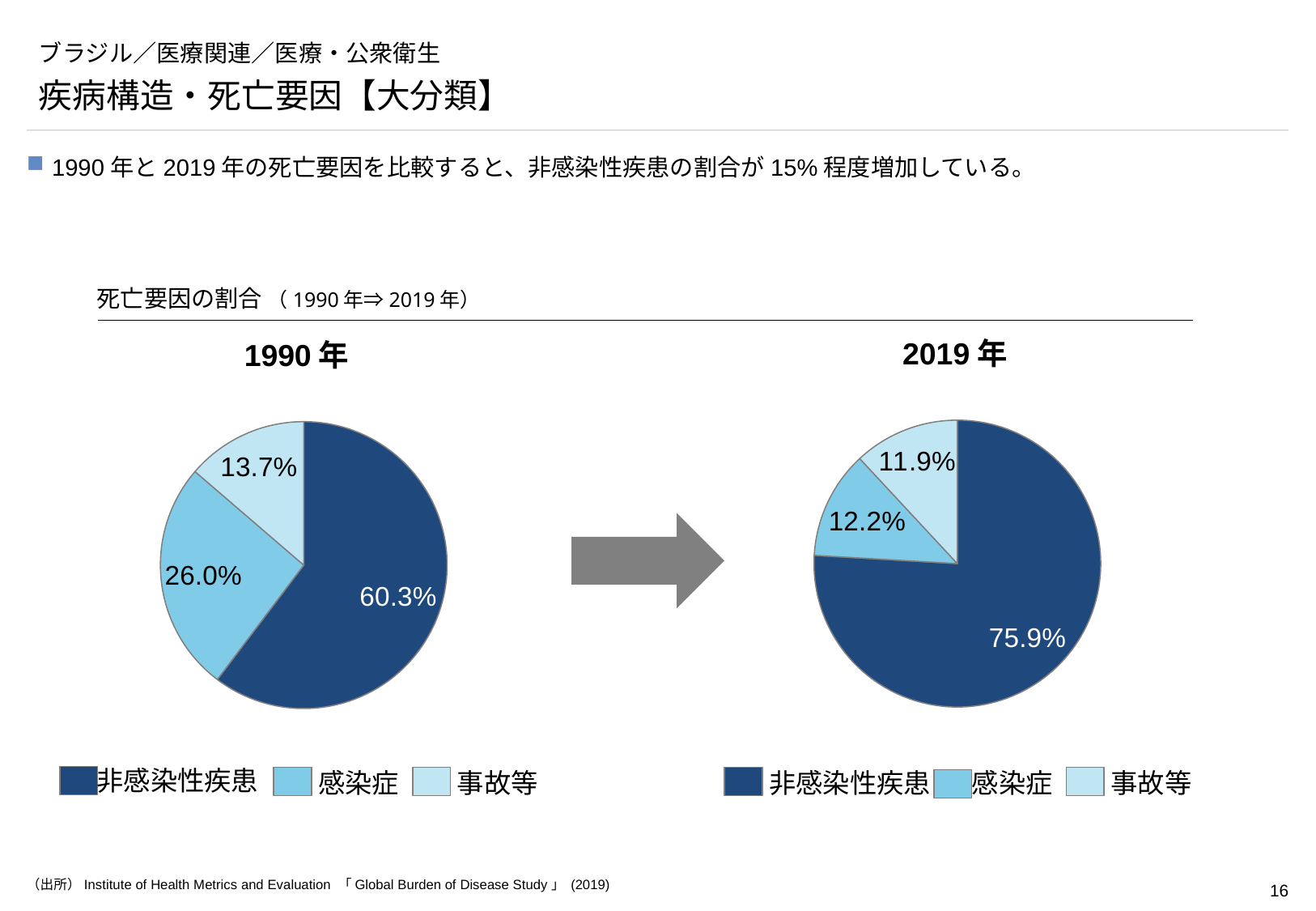
In the 1990年 pie chart, what share is shown for 非感染性疾患? 60.3% What kind of chart is used to show the 1990年 data? Pie chart In the 1990年 pie chart, which category has the largest share? 非感染性疾患 In the 1990年 pie chart, which category has the smallest share? 事故等 In the 2019年 pie chart, what share is shown for 非感染性疾患? 75.9% How many categories does the legend of the 2019年 pie chart list? 3 In the 2019年 pie chart, what share is shown for 事故等? 11.9% What is the difference between the 非感染性疾患 share in the 2019年 pie chart and in the 1990年 pie chart? 15.6% In the 1990年 pie chart, what share is shown for 感染症? 26.0% In the 1990年 pie chart, what is the difference between the 感染症 share and the 事故等 share? 12.3% In the 2019年 pie chart, which category has the smallest share? 事故等 Which is larger: the 感染症 share in the 1990年 pie chart or the 感染症 share in the 2019年 pie chart? 1990年